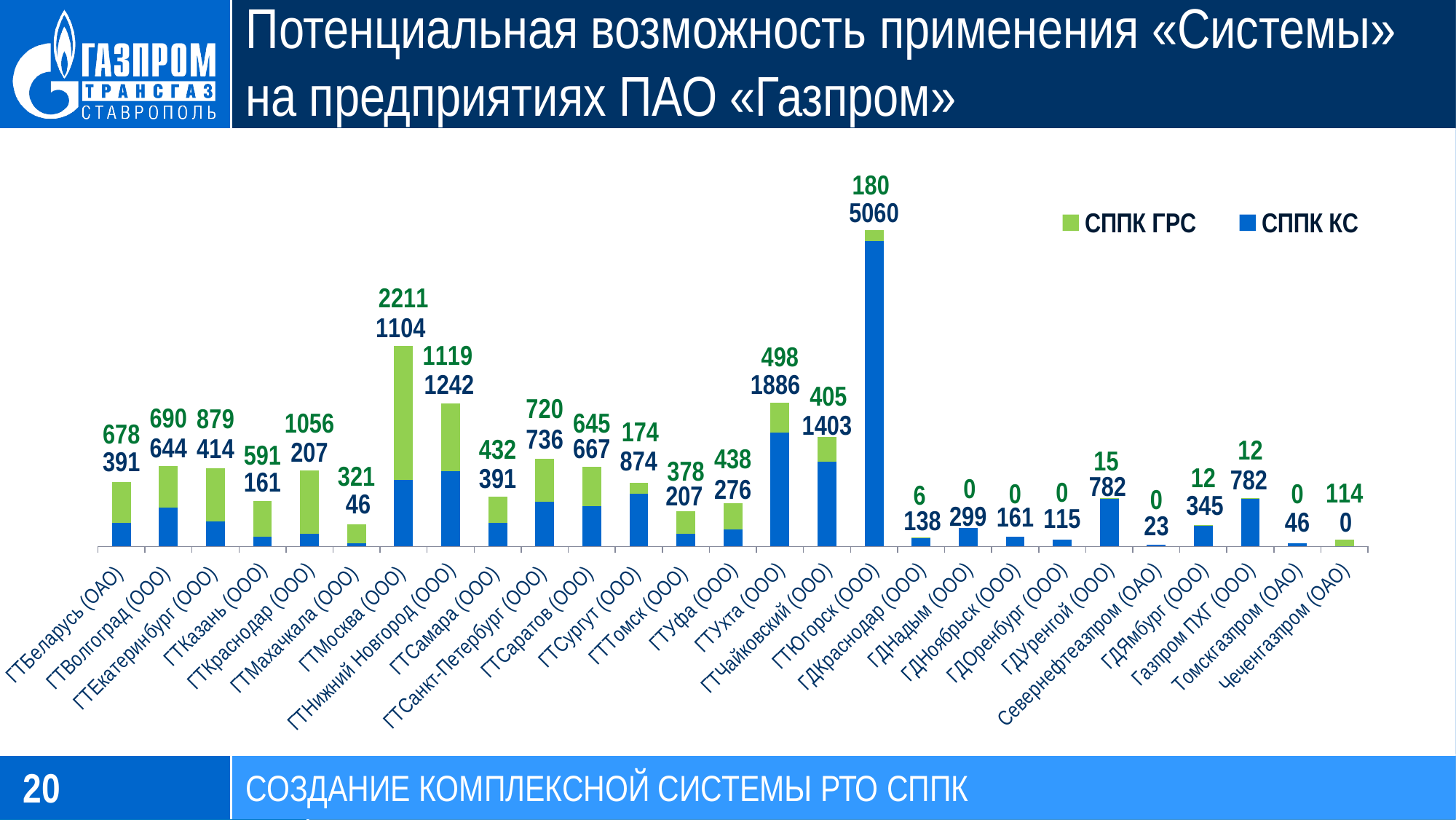
Which is larger: the СППК ГРС value for ГТКраснодар (ООО) or for ГТЕкатеринбург (ООО)? ГТКраснодар (ООО) Which enterprise has the highest СППК ГРС value? ГТМосква (ООО) What is the total of the stacked bar for ГТМосква (ООО)? 3315 How many series does the legend list? 2 Which enterprise has the highest СППК КС value? ГТЮгорск (ООО) What is the СППК КС value for ГТУхта (ООО)? 1886 What is the СППК КС value for ГТЮгорск (ООО)? 5060 What type of chart is shown on the slide? bar chart What is the СППК ГРС value for ГТМосква (ООО)? 2211 Which colour represents the СППК ГРС series in the legend? green How many categories (enterprises) are shown on the x axis? 27 What is the difference between the СППК КС values of ГТНижний Новгород (ООО) and ГТМосква (ООО)? 138